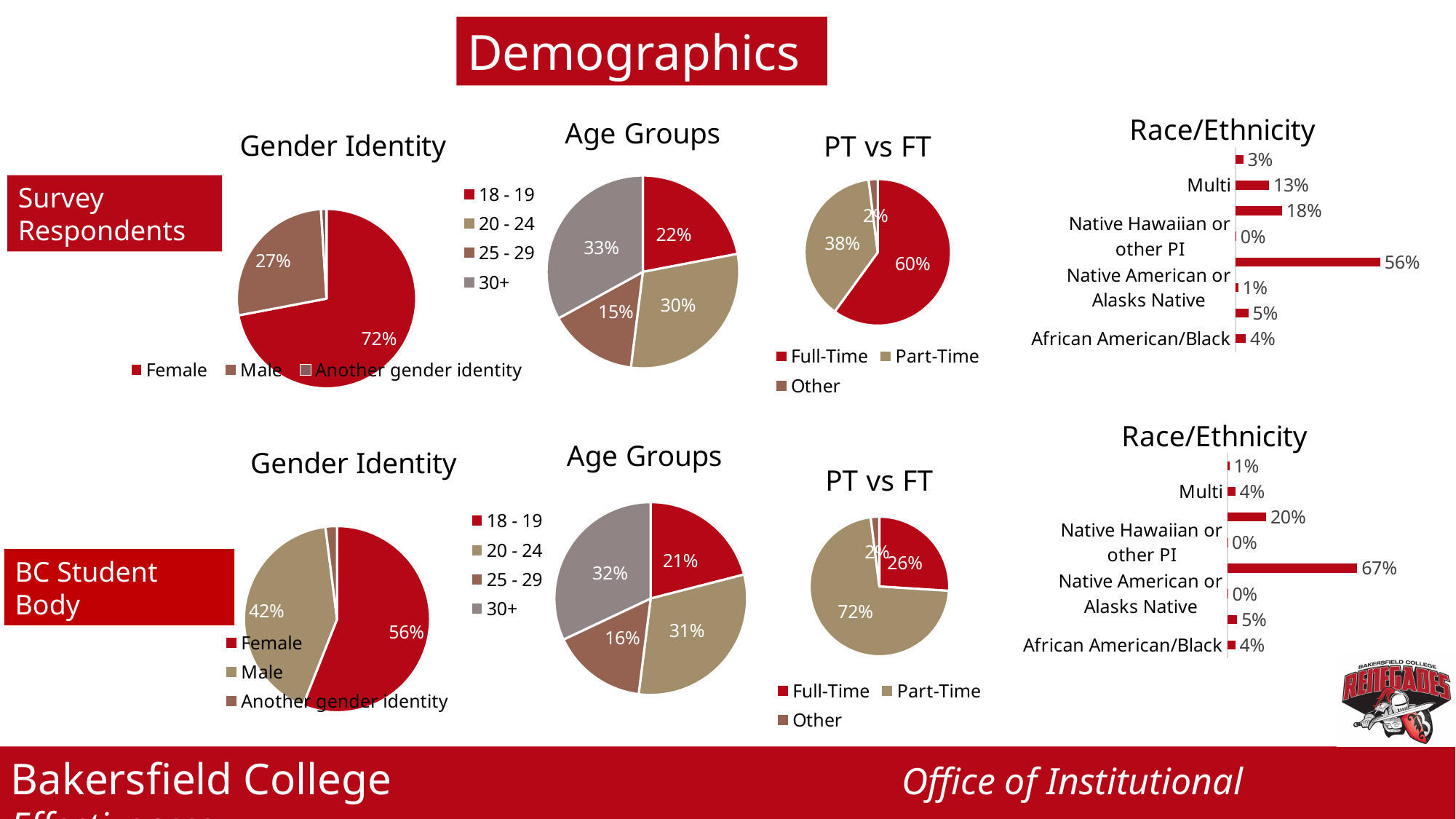
In the BC Student Body Age Groups pie chart, what percentage is the 25 - 29 group? 16% What type of chart is the Survey Respondents Race/Ethnicity chart? Bar chart In the Survey Respondents Race/Ethnicity chart, what is the value for Multi? 13% In the Survey Respondents Gender Identity pie chart, what share is Female? 72% In the Survey Respondents Age Groups pie chart, which age group has the largest share? 30+ In the BC Student Body Gender Identity pie chart, what share is Male? 42% In the BC Student Body PT vs FT pie chart, what percentage is Part-Time? 72% In the Survey Respondents Gender Identity pie chart, what percentage is Male? 27% In the BC Student Body PT vs FT pie chart, which is larger, Full-Time or Part-Time? Part-Time In the Survey Respondents PT vs FT pie chart, what share is Full-Time? 60% In the BC Student Body Race/Ethnicity chart, what is the value for African American/Black? 4% In the Survey Respondents Age Groups pie chart, what is the difference in percentage points between the 30+ group and the 25 - 29 group? 18 percentage points